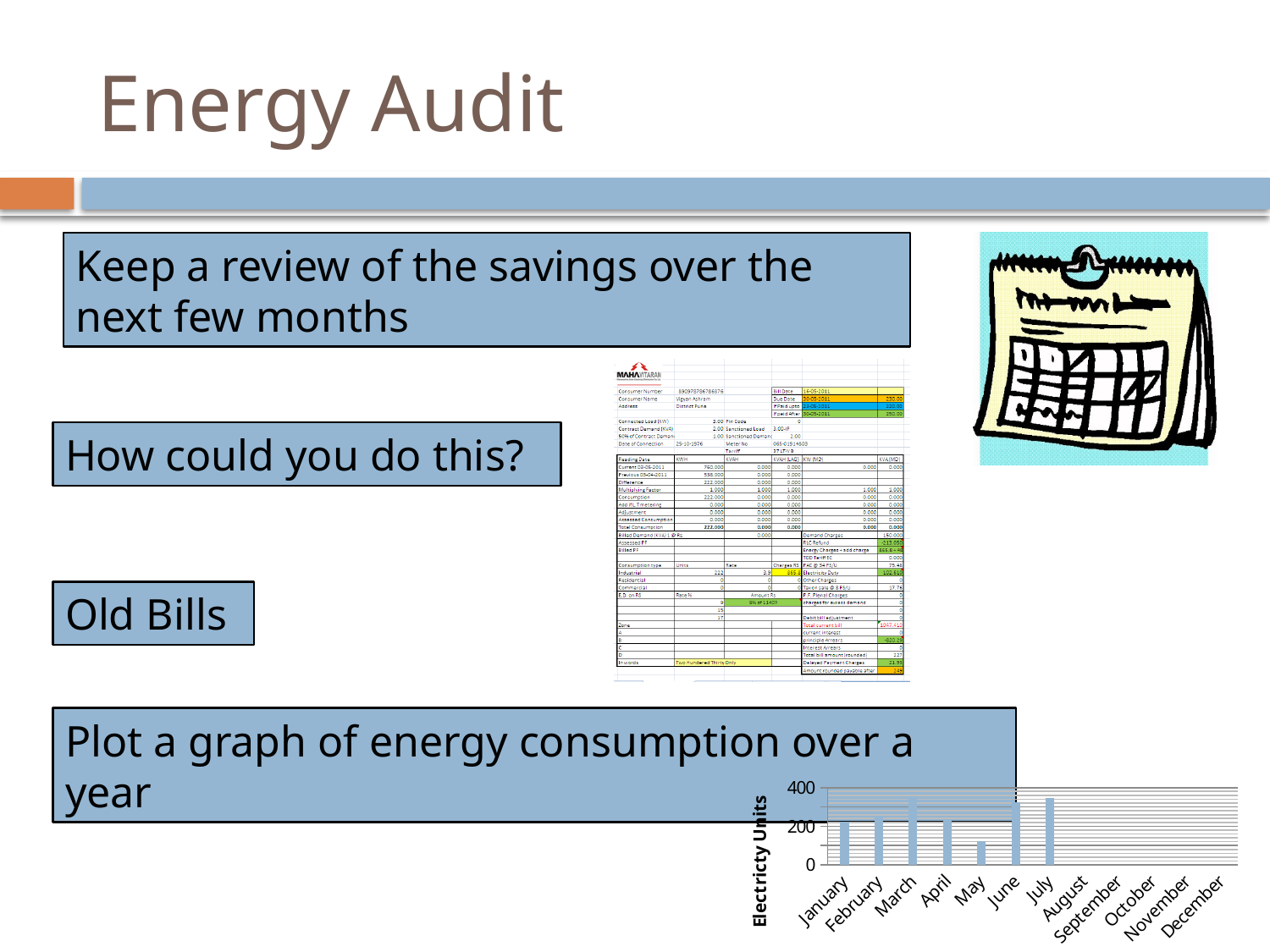
What is the first category on the x axis of the bar chart? January What is the label on the vertical axis of the bar chart? Electricty Units How many months are listed along the x axis of the bar chart? 12 What kind of chart is shown at the bottom right of the slide? bar chart Is the value for January in the bar chart greater or less than 400? less What is the highest tick value shown on the vertical axis of the bar chart? 400